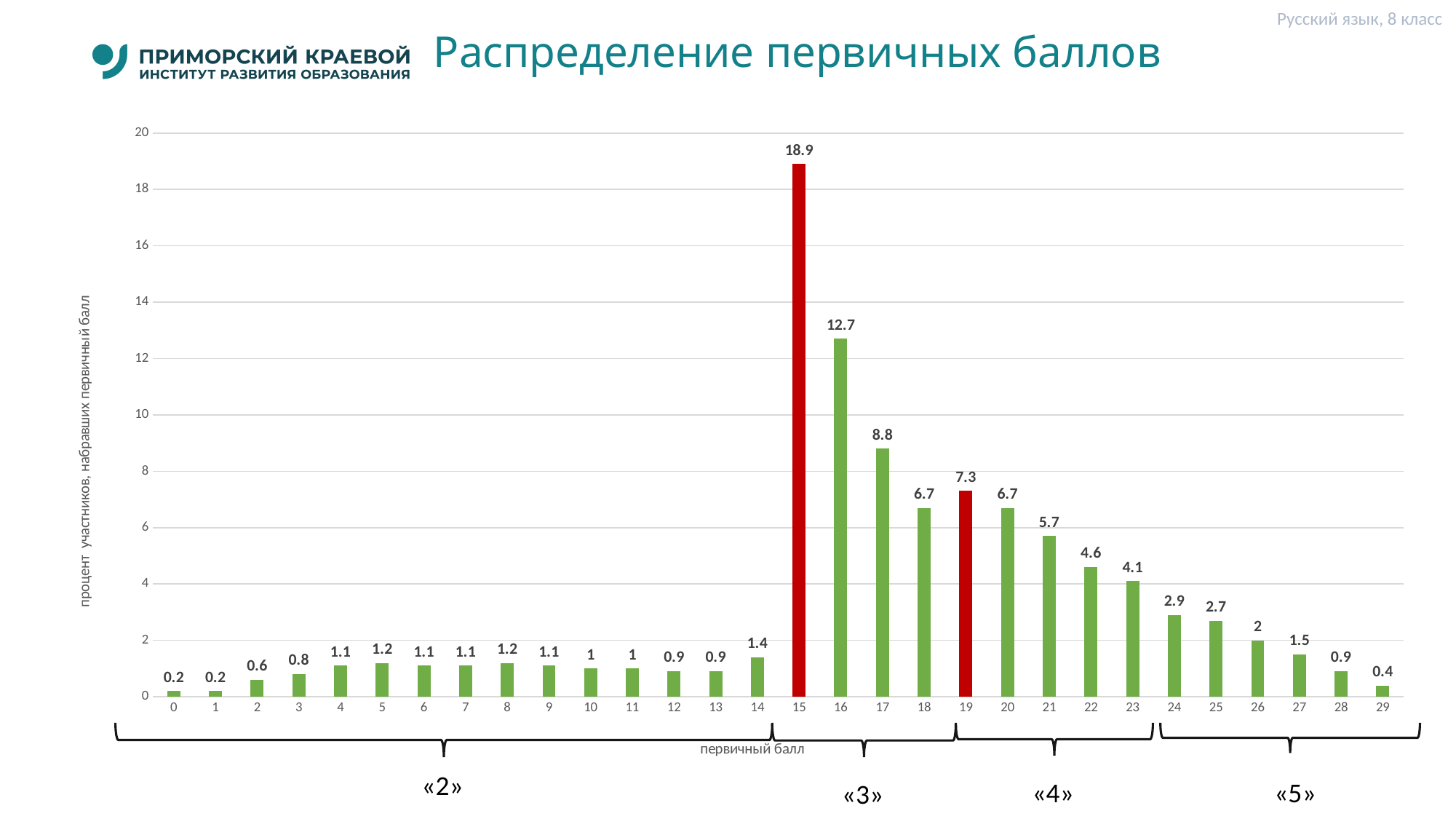
Is the value for primary score 16 greater or less than 12? greater What is the difference between the values for primary scores 15 and 16? 6.2 Which two primary scores are shown with red bars? 15 and 19 What is the title of the chart? Распределение первичных баллов Do the values rise or fall along the x axis from primary score 15 to 18? fall Which is larger, the value for primary score 17 or for primary score 21? 17 What kind of chart is shown on the slide? bar chart What is the value for primary score 19? 7.3 How many primary score categories are shown on the x axis? 30 What is the value for primary score 24? 2.9 Which primary score has the highest percentage of participants? 15 What is the value for primary score 15? 18.9